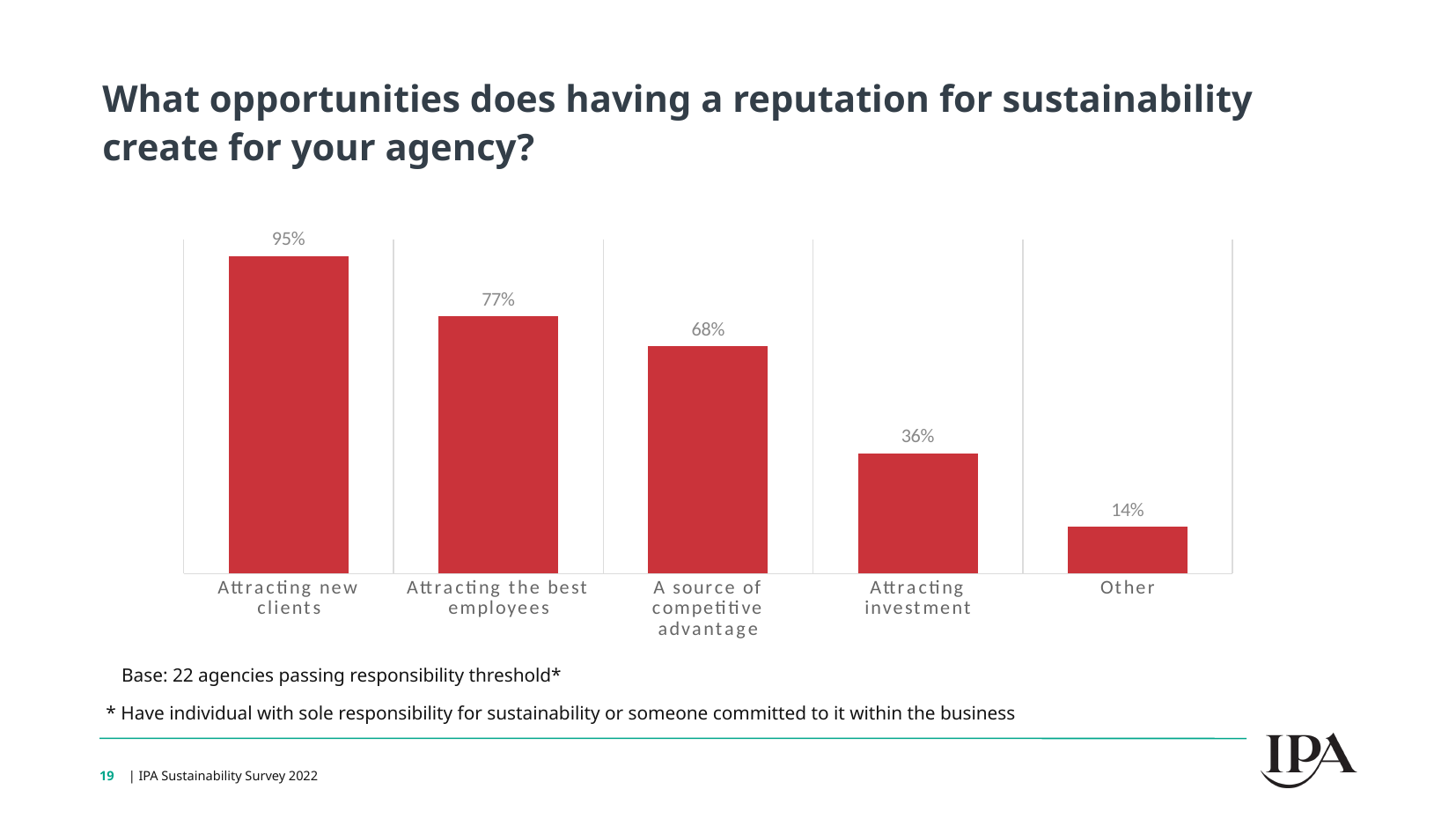
What is the value for 'Attracting investment'? 36% Which category has the lowest value? Other What is the base size stated below the chart? 22 agencies passing responsibility threshold What is the value for 'A source of competitive advantage'? 68% What kind of chart is shown on the slide? Bar chart What percentage of agencies cited attracting new clients as an opportunity? 95% What is the difference between the values for 'Attracting new clients' and 'Attracting investment'? 59% Which category has the highest value? Attracting new clients What is the value for 'Attracting the best employees'? 77% Do the values rise or fall from left to right across the categories? Fall How many categories are shown in the chart? 5 Which is larger: the value for 'Attracting the best employees' or 'A source of competitive advantage'? Attracting the best employees